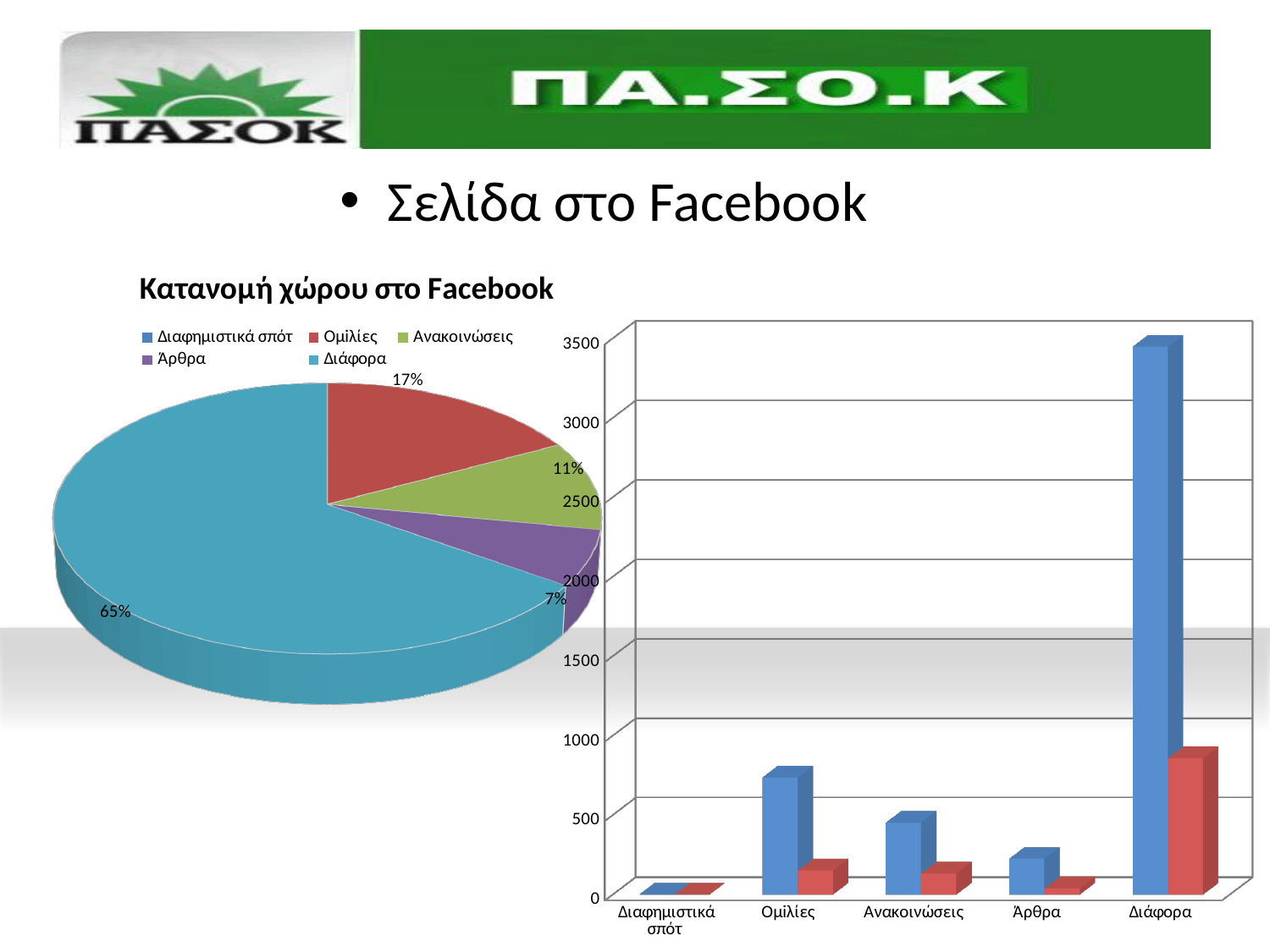
On the bar chart on the right, is the blue bar for Ομιλίες greater or less than 1000? less On the pie chart titled 'Κατανομή χώρου στο Facebook', how many entries does the legend list? 5 On the bar chart on the right, which category has the tallest blue bar? Διάφορα What kind of chart is the chart on the left of the slide? Pie chart On the pie chart titled 'Κατανομή χώρου στο Facebook', what share does Διάφορα have? 65% On the pie chart titled 'Κατανομή χώρου στο Facebook', how many percentage points larger is the Διάφορα share than the Ομιλίες share? 48 percentage points What kind of chart is the chart on the right of the slide? Bar chart On the bar chart on the right, is the blue bar for Διάφορα greater or less than 3000? greater On the pie chart titled 'Κατανομή χώρου στο Facebook', what share does Ανακοινώσεις have? 11% On the pie chart titled 'Κατανομή χώρου στο Facebook', what share does Άρθρα have? 7% On the pie chart titled 'Κατανομή χώρου στο Facebook', which category has the largest slice? Διάφορα